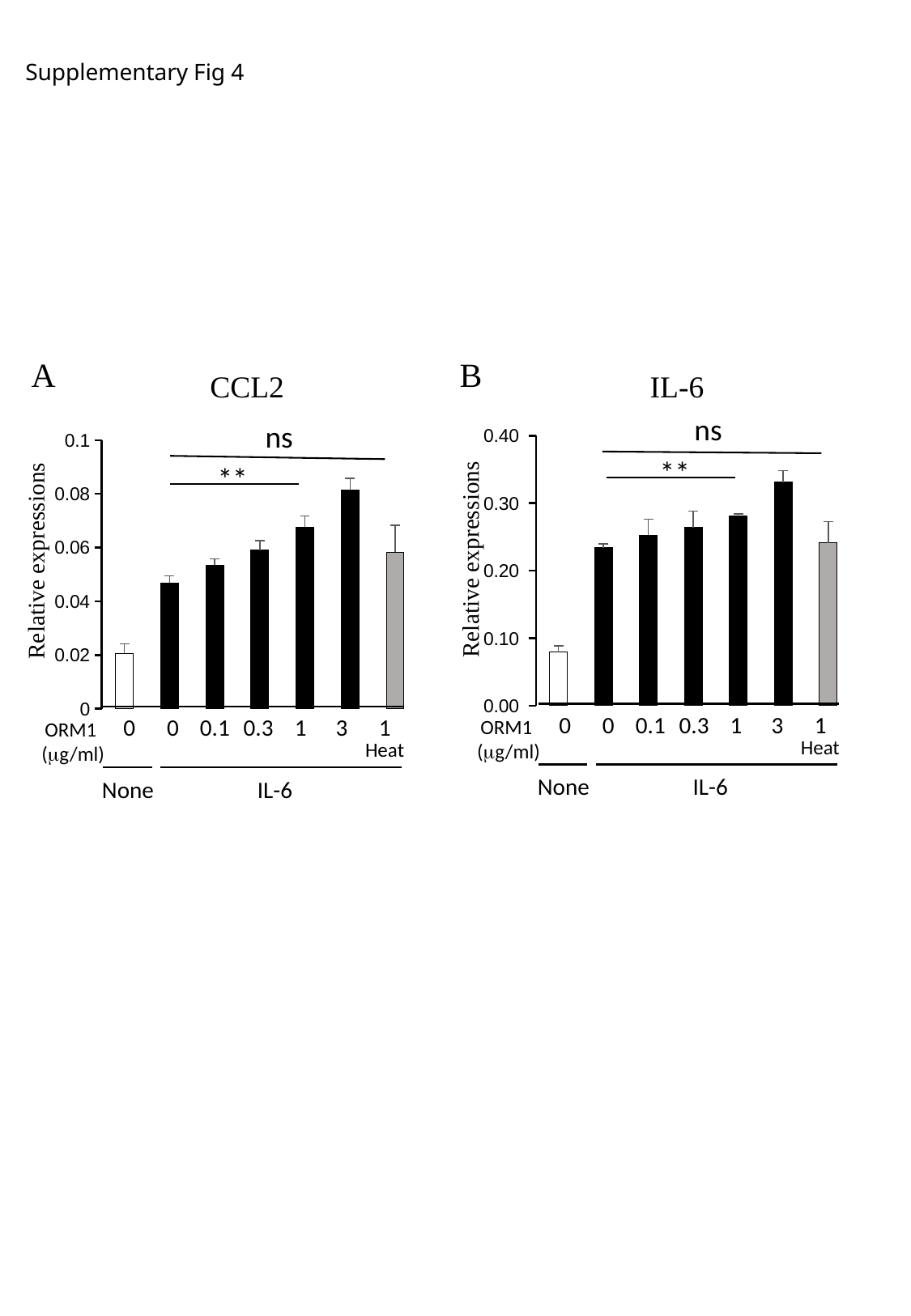
In the IL-6 chart (panel B), which bar is the lowest? ORM1 0 (None) In the IL-6 chart (panel B), is the value for ORM1 0 (None) greater or less than 0.10? less In the IL-6 chart (panel B), which bar is the highest? ORM1 3 (IL-6) What kind of chart is the CCL2 chart (panel A)? bar chart In the CCL2 chart (panel A), which bar is the lowest? ORM1 0 (None) How many bars are plotted in the IL-6 chart (panel B)? 7 What is the y-axis label of the IL-6 chart (panel B)? Relative expressions In the CCL2 chart (panel A), do the values rise or fall as the ORM1 concentration increases from 0 to 3 under IL-6? rise In the CCL2 chart (panel A), is the value for ORM1 0 (None) greater or less than 0.04? less In the IL-6 chart (panel B), is the value for ORM1 3 (IL-6) greater or less than 0.30? greater In the CCL2 chart (panel A), which bar is the highest? ORM1 3 (IL-6)